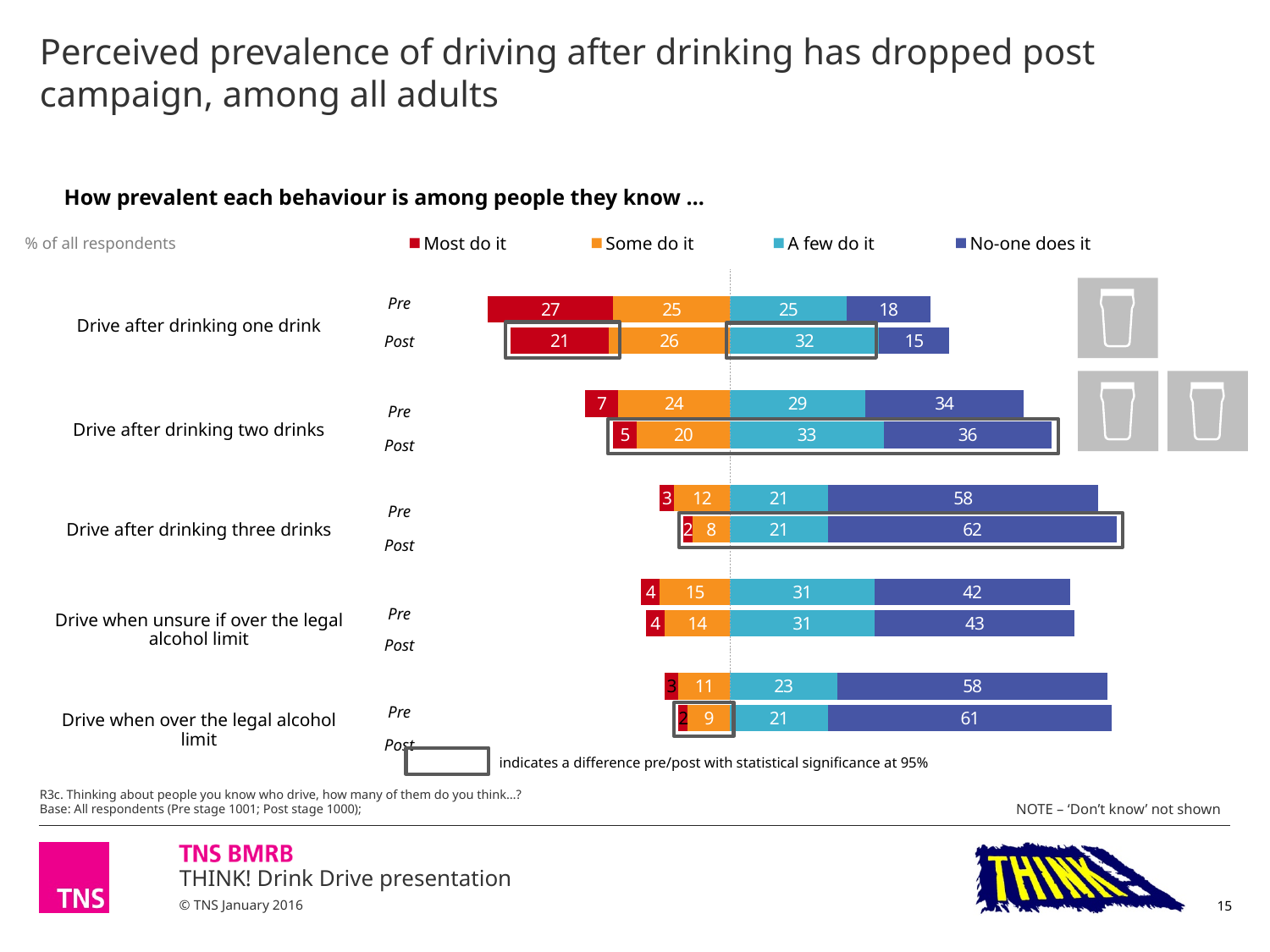
Which behaviour has the highest 'Most do it' value at the Pre stage? Drive after drinking one drink How many behaviours are listed on the chart? 5 What is the difference between the Pre and Post 'Most do it' values for 'Drive after drinking one drink'? 6 Which is larger for 'Drive when over the legal alcohol limit': the Pre 'No-one does it' value or the Post 'No-one does it' value? Post (61) How many series does the legend list? 4 Which colour represents 'No-one does it' in the legend? Dark blue Which behaviour has the lowest 'No-one does it' value at the Post stage? Drive after drinking one drink What is the 'No-one does it' value for 'Drive after drinking three drinks' at the Post stage? 62 What is the 'A few do it' value for 'Drive after drinking two drinks' at the Pre stage? 29 What is the total of the Post stacked bar for 'Drive after drinking two drinks'? 94 What kind of chart is shown on the slide? Stacked bar chart What is the 'Most do it' value for 'Drive after drinking one drink' at the Post stage? 21